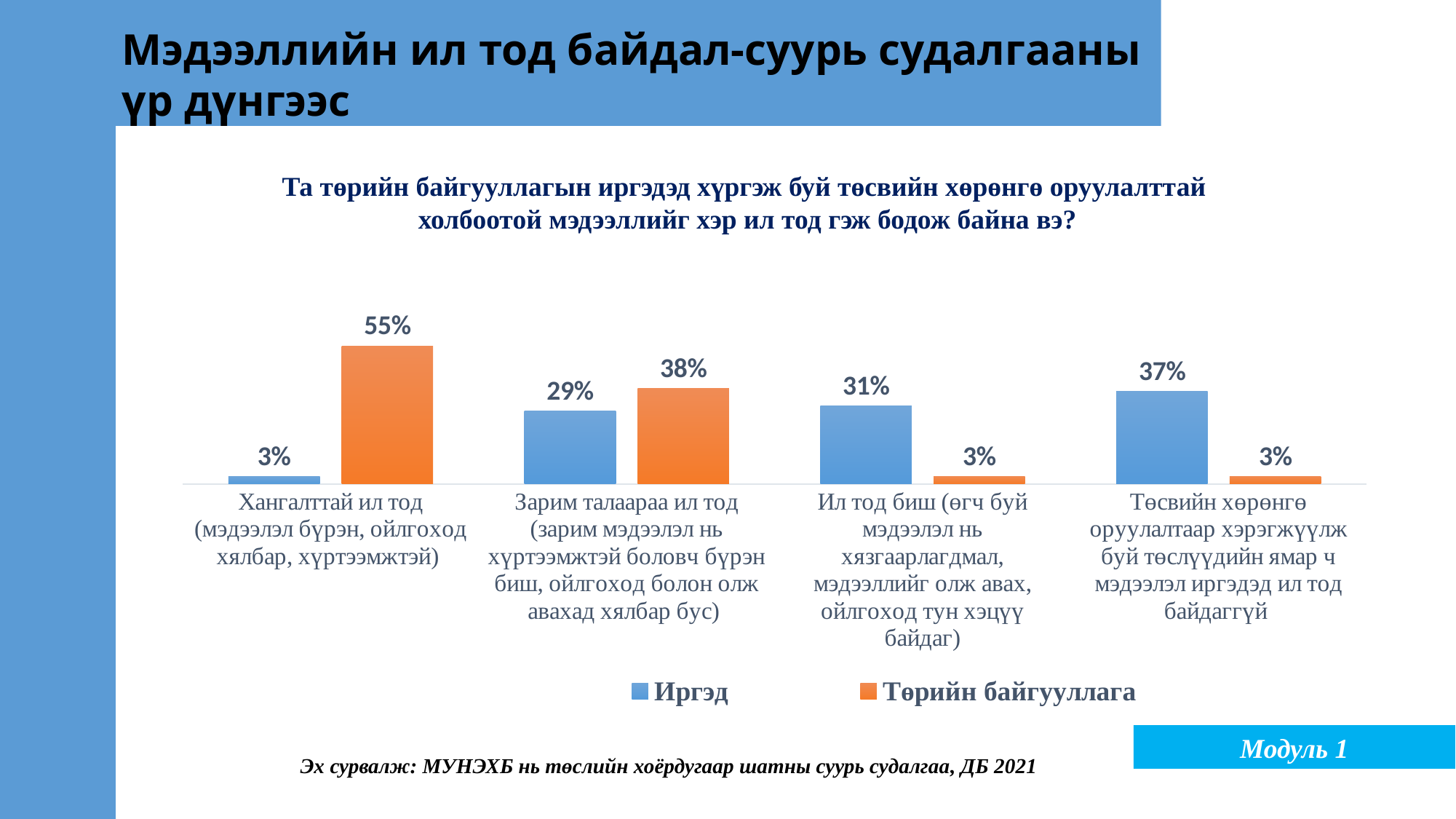
How many categories are shown on the x axis of the chart? 4 How many series does the chart legend list? 2 What is the difference between the Төрийн байгууллага and Иргэд values in the category 'Хангалттай ил тод'? 52% What is the value for Төрийн байгууллага in the category 'Хангалттай ил тод'? 55% What is the value for Иргэд in the category 'Зарим талаараа ил тод'? 29% Which category has the highest value for the Иргэд series? Төсвийн хөрөнгө оруулалтаар хэрэгжүүлж буй төслүүдийн ямар ч мэдээлэл иргэдэд ил тод байдаггүй What is the value for Иргэд in the category 'Хангалттай ил тод'? 3% Which colour represents the Төрийн байгууллага series in the chart? Orange Which category has the lowest value for the Иргэд series? Хангалттай ил тод What type of chart is shown on the slide? Bar chart What is the value for Төрийн байгууллага in the category 'Ил тод биш'? 3% In the category 'Зарим талаараа ил тод', which series has the larger value, Иргэд or Төрийн байгууллага? Төрийн байгууллага